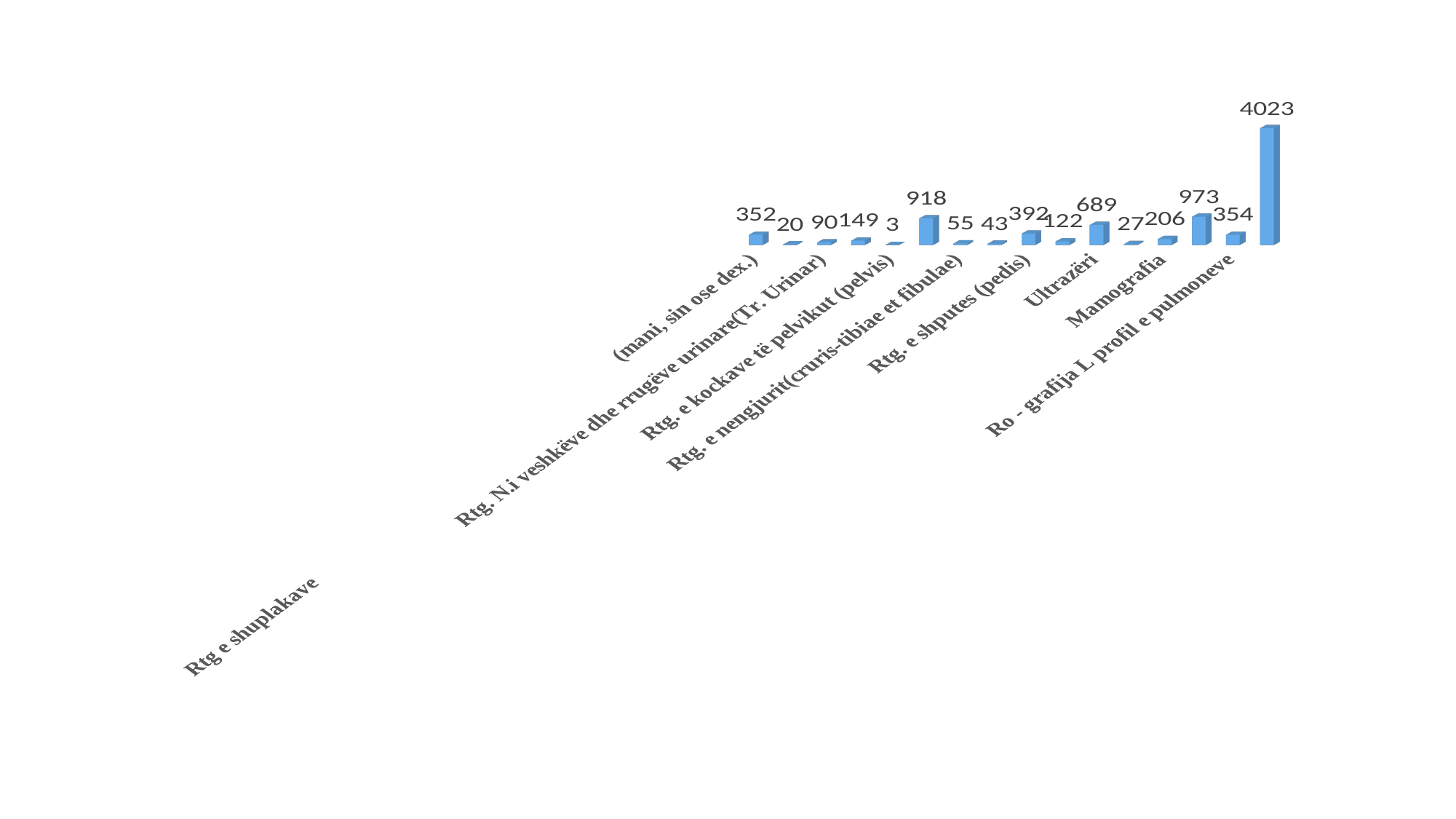
What colour are the bars in the chart? blue What type of chart is shown on the slide? bar chart Which is larger, the value for Ultrazëri or the value for Mamografia? Ultrazëri What is the value for Mamografia? 206 What is the value for Ultrazëri? 689 What is the difference between the values for Ultrazëri and Mamografia? 483 How many bars are plotted in the chart? 16 What is the lowest value shown in the chart? 3 What is the second highest value shown in the chart? 973 What is the difference between the highest value (4023) and the lowest value (3) in the chart? 4020 What is the highest value shown in the chart? 4023 What is the value for Ro - grafija L profil e pulmoneve? 354